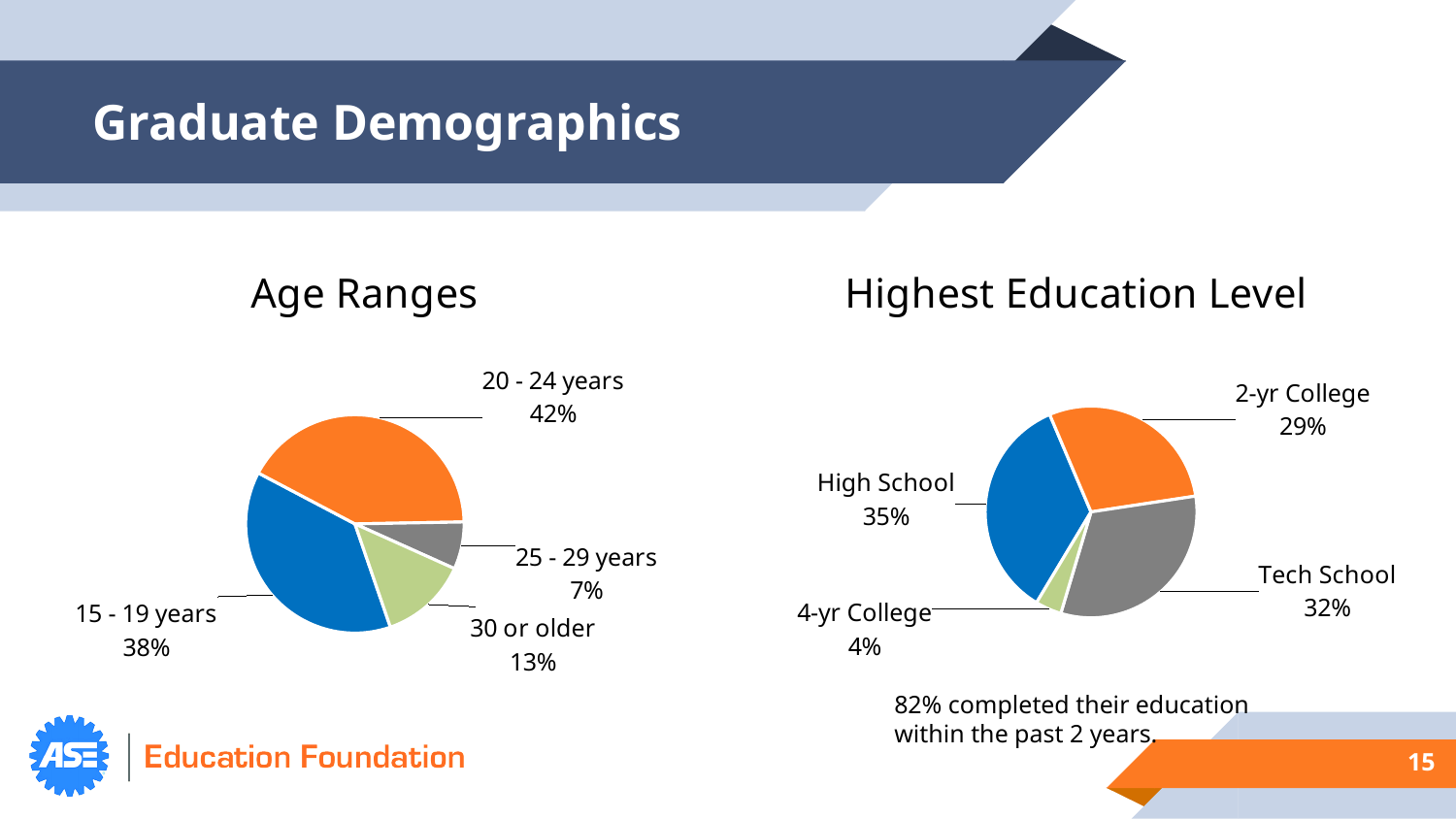
In the Age Ranges chart, how many age categories are shown? 4 In the Highest Education Level chart, which is larger: the share for 2-yr College or the share for Tech School? Tech School In the Highest Education Level chart, which education level has the smallest share? 4-yr College In the Highest Education Level chart, which education level has the largest share? High School What type of chart is the Age Ranges chart? Pie chart What is the title of the pie chart on the right side of the slide? Highest Education Level In the Age Ranges chart, which age range has the smallest share? 25 - 29 years In the Age Ranges chart, what is the difference between the shares for 15 - 19 years and 30 or older? 25% In the Age Ranges chart, what share of graduates are 20 - 24 years old? 42% In the Highest Education Level chart, what is the difference between the shares for High School and 4-yr College? 31% In the Age Ranges chart, which age range has the largest share? 20 - 24 years In the Highest Education Level chart, what share of graduates have Tech School as their highest education level? 32%